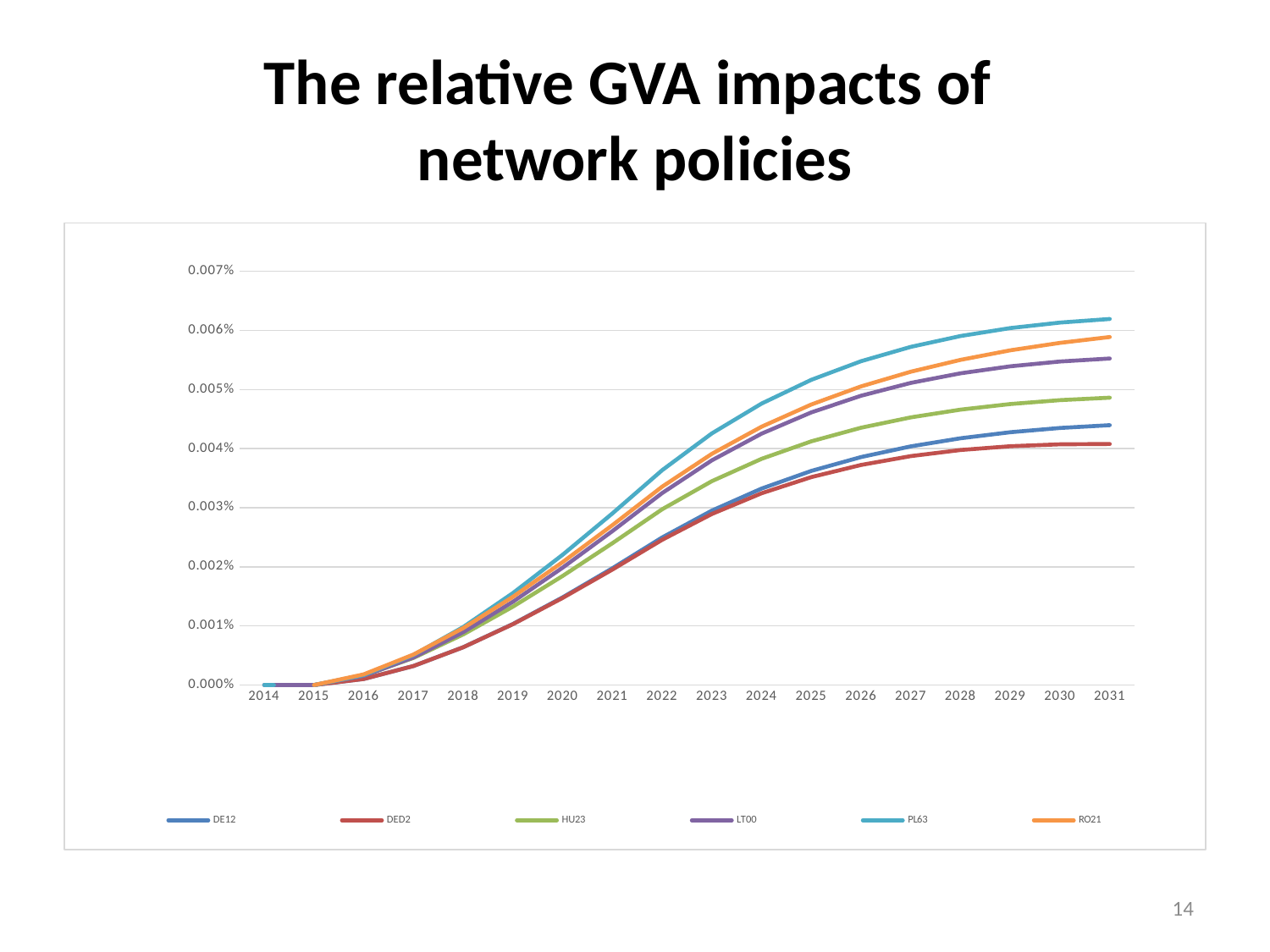
Do the values for PL63 rise or fall from 2014 to 2031? Rise Is the value for LT00 in 2031 greater or less than 0.005%? greater How many years are shown along the x axis? 18 What is the value for DE12 in 2014? 0.000% Which series has the lowest value in 2031? DED2 Which series has the highest value in 2031? PL63 Is the value for DE12 in 2025 greater or less than 0.004%? less How many series does the legend list? 6 Is the value for PL63 in 2031 greater or less than 0.005%? greater What kind of chart is shown on the slide? Line chart In 2031, which is larger, the value for RO21 or the value for HU23? RO21 What is the title of the slide containing the chart? The relative GVA impacts of network policies